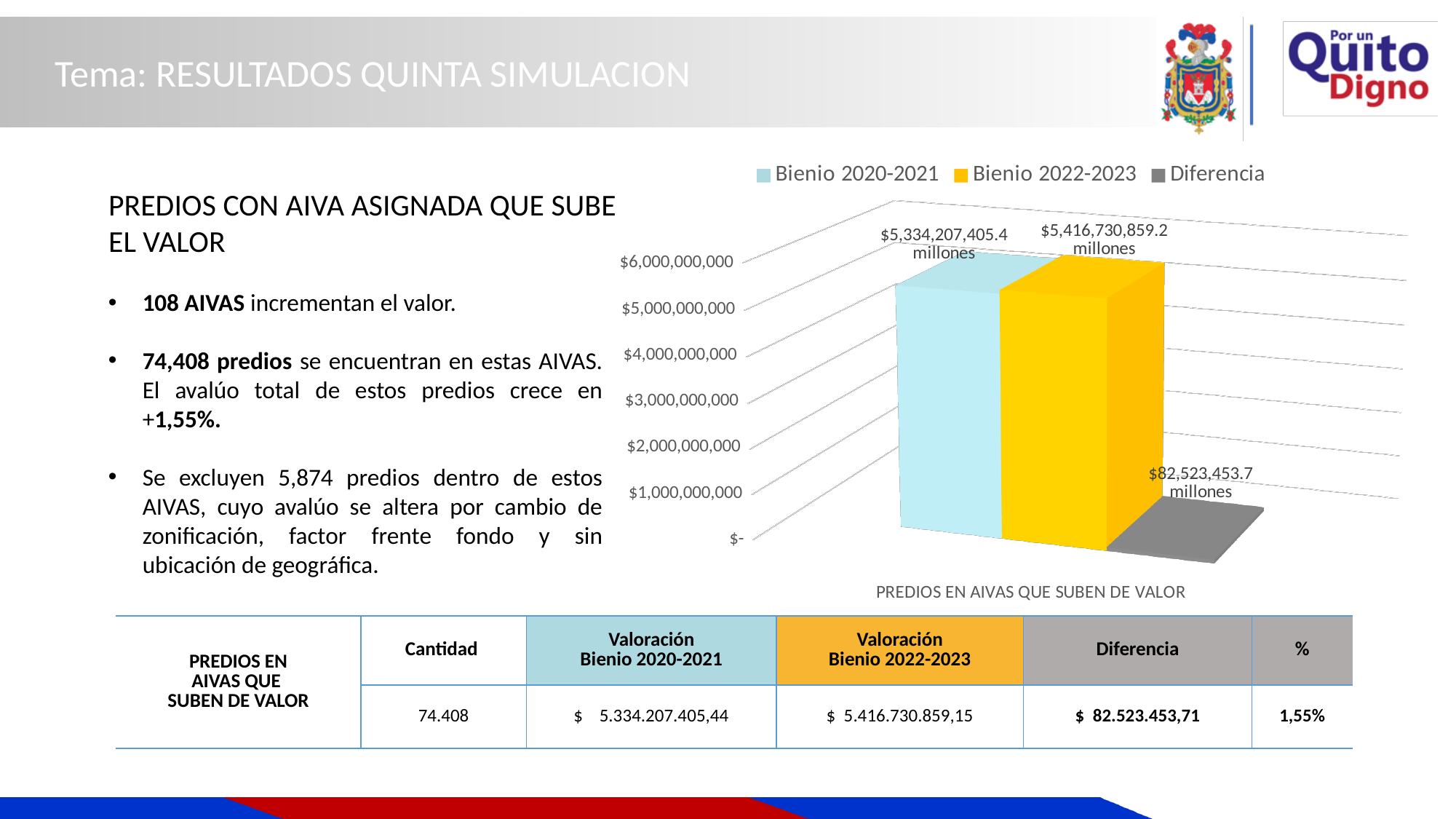
What colour is the Bienio 2022-2023 bar in the chart? yellow Is the value of the Bienio 2020-2021 bar greater or less than $5,000,000,000? greater What kind of chart is shown on the slide? bar chart Which series has the highest value in the chart? Bienio 2022-2023 What is the value of the Diferencia bar in the chart? $82,523,453.7 millones Which is larger in the chart, the Bienio 2020-2021 bar or the Bienio 2022-2023 bar? Bienio 2022-2023 Is the value of the Diferencia bar greater or less than $1,000,000,000? less What is the category label shown below the chart? PREDIOS EN AIVAS QUE SUBEN DE VALOR Which series has the lowest value in the chart? Diferencia What is the value of the Bienio 2020-2021 bar in the chart? $5,334,207,405.4 millones How many series does the chart legend list? 3 What is the value of the Bienio 2022-2023 bar in the chart? $5,416,730,859.2 millones